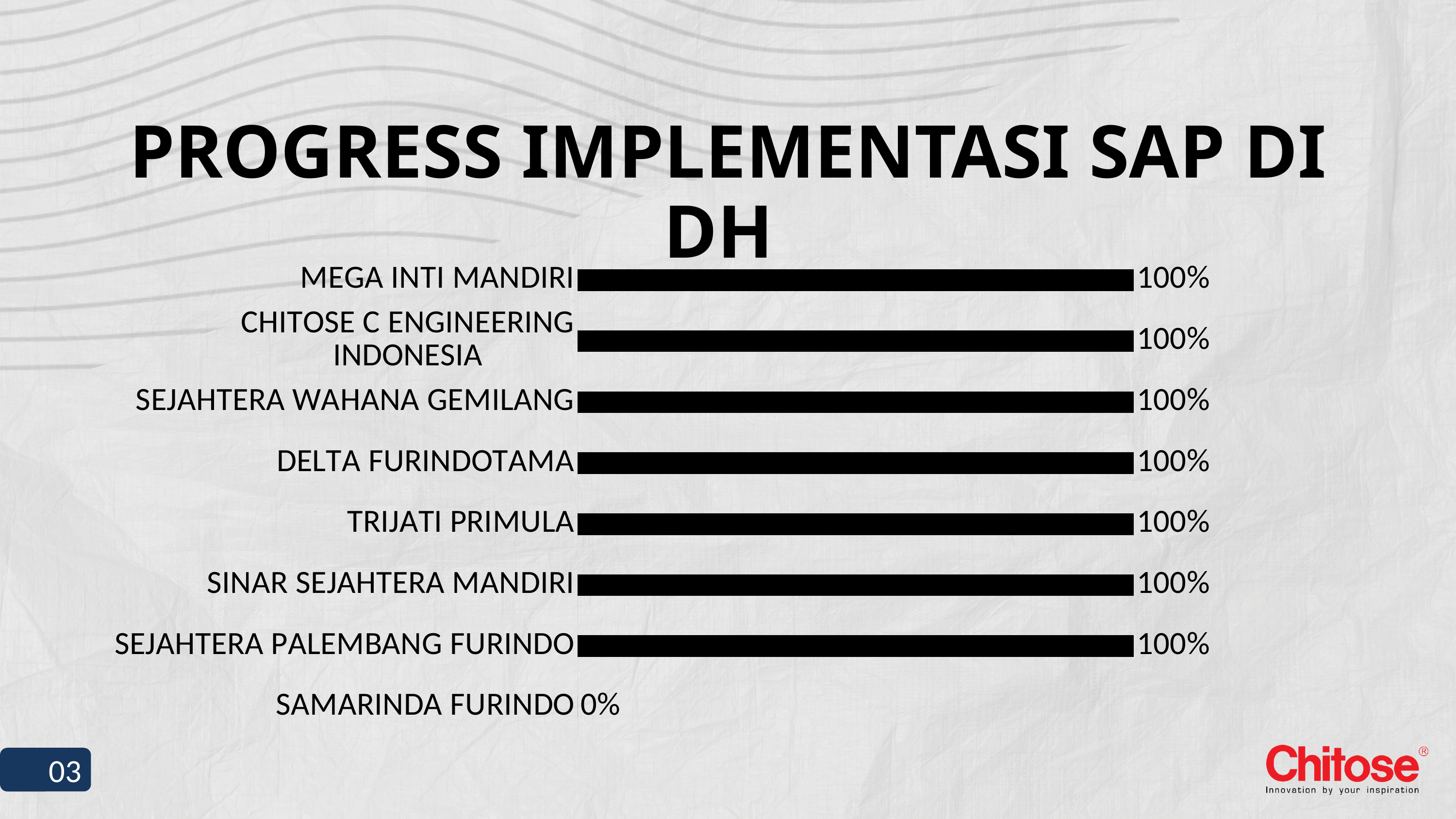
What is the value for SAMARINDA FURINDO? 0% What kind of chart is shown on the slide? bar chart What is the title of the slide? PROGRESS IMPLEMENTASI SAP DI DH How many categories have a value of 100%? 7 Which category has the lowest value? SAMARINDA FURINDO What colour are the bars in the chart? black What is the value for SEJAHTERA PALEMBANG FURINDO? 100% Which is larger, the value for DELTA FURINDOTAMA or the value for SAMARINDA FURINDO? DELTA FURINDOTAMA What is the value for MEGA INTI MANDIRI? 100% What is the difference between the values for TRIJATI PRIMULA and SAMARINDA FURINDO? 100% What is the value for CHITOSE C ENGINEERING INDONESIA? 100% How many categories are shown in the chart? 8